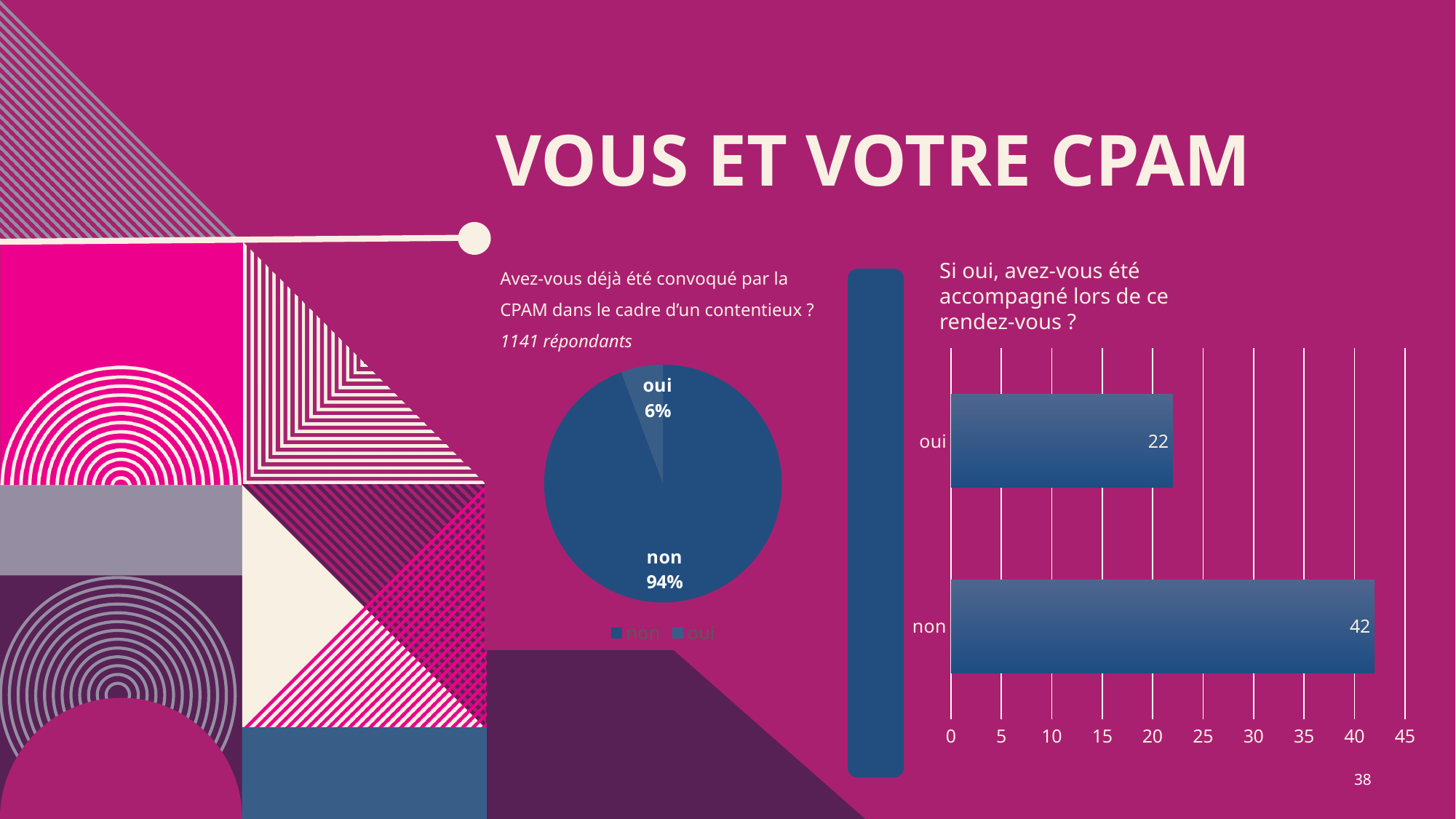
In the pie chart on the left, how many slices are there? 2 In the bar chart on the right, what is the value for 'oui'? 22 What kind of chart is the chart on the right? bar chart In the pie chart on the left, what share of respondents answered 'non'? 94% In the pie chart on the left, how many respondents are stated below the question? 1141 In the bar chart on the right, what is the difference between the values for 'non' and 'oui'? 20 In the bar chart on the right, what is the value for 'non'? 42 What kind of chart is the chart on the left? pie chart In the bar chart on the right, is the value for 'non' greater or less than 40? greater In the pie chart on the left, which answer has the largest share? non In the pie chart on the left, what share of respondents answered 'oui'? 6% In the bar chart on the right, which category has the highest value? non